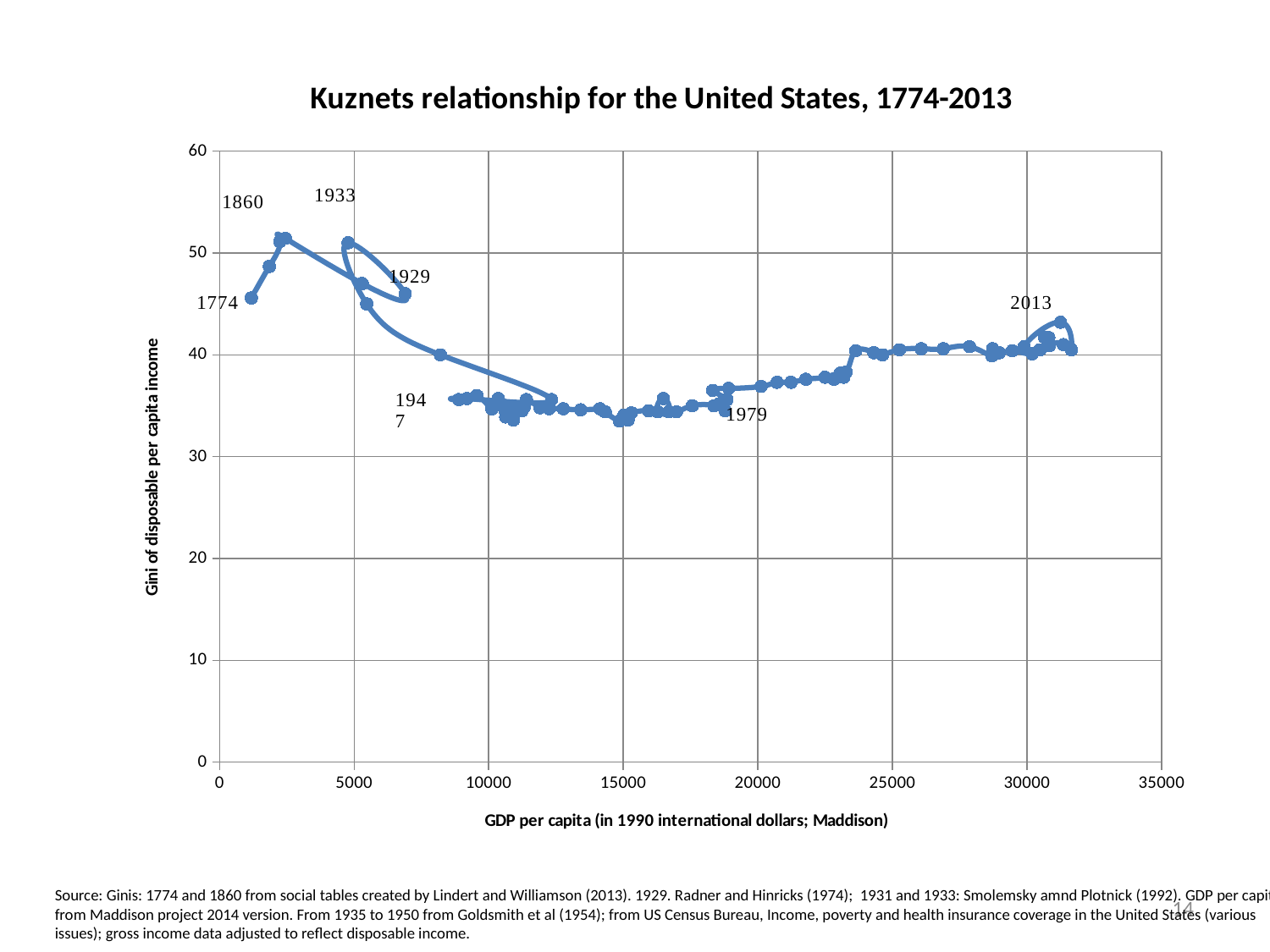
What is the title of the chart? Kuznets relationship for the United States, 1774-2013 Which has the higher Gini value, the point labelled 1947 or the point labelled 1933? 1933 Is the Gini value for the point labelled 2013 greater or less than 40? greater Is the Gini value for the point labelled 1929 greater or less than 50? less Is the Gini value for the point labelled 1947 greater or less than 40? less Which has the higher Gini value, the point labelled 1860 or the point labelled 1774? 1860 What is the label of the x axis? GDP per capita (in 1990 international dollars; Maddison) What kind of chart is shown on the slide? scatter chart with connected points Which has the higher Gini value, the point labelled 2013 or the point labelled 1979? 2013